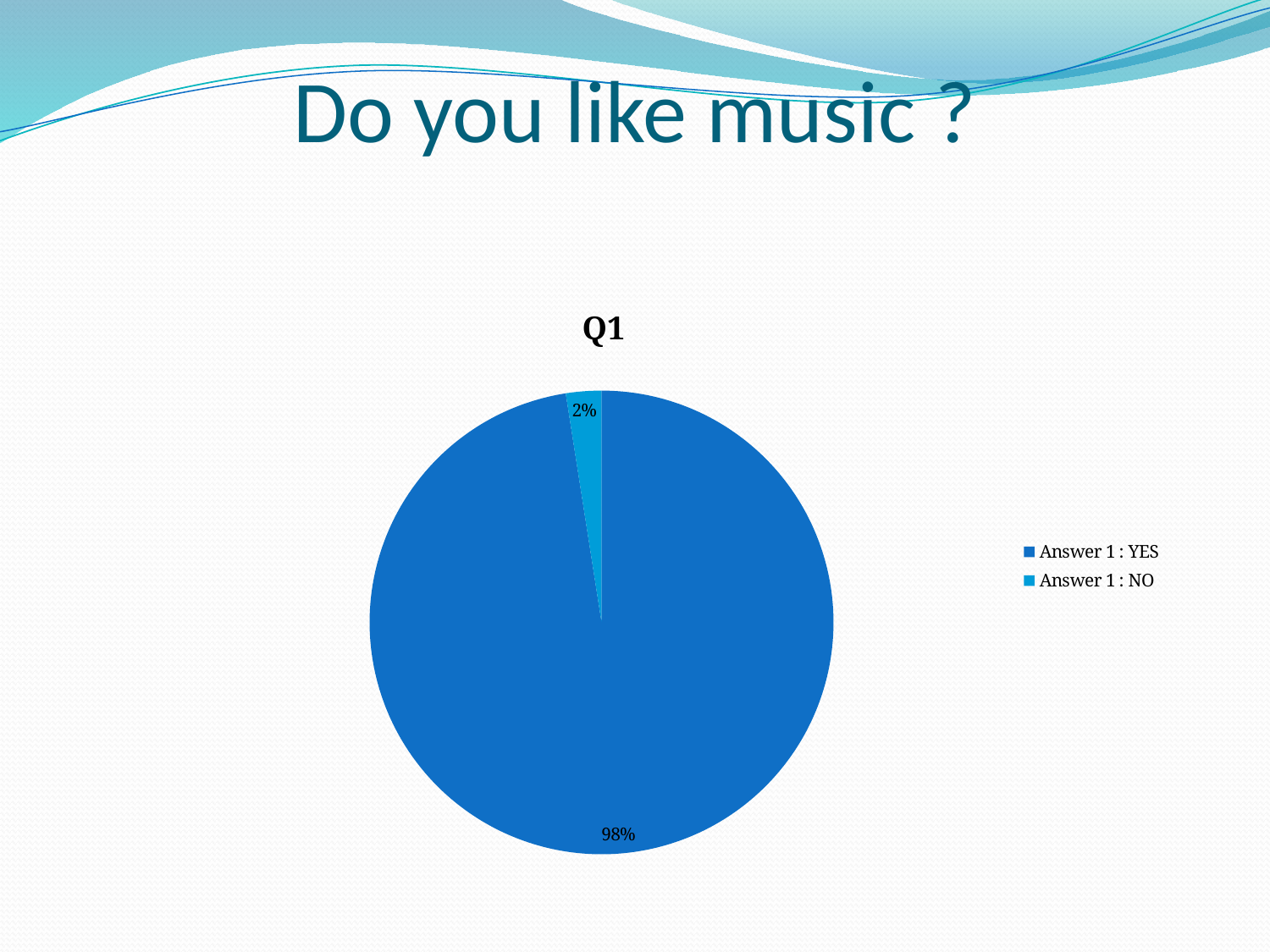
How many entries does the legend list? 2 What type of chart is shown on the slide? Pie chart Which slice is the largest? Answer 1 : YES What is the chart's title? Q1 What is the difference in percentage points between the YES and NO slices? 96 What is the question written as the slide heading above the chart? Do you like music ? Which slice is the smallest? Answer 1 : NO How many slices does the pie chart have? 2 Which is larger, the YES slice or the NO slice? Answer 1 : YES What share of the pie is labelled "Answer 1 : NO"? 2% What share of the pie is labelled "Answer 1 : YES"? 98%